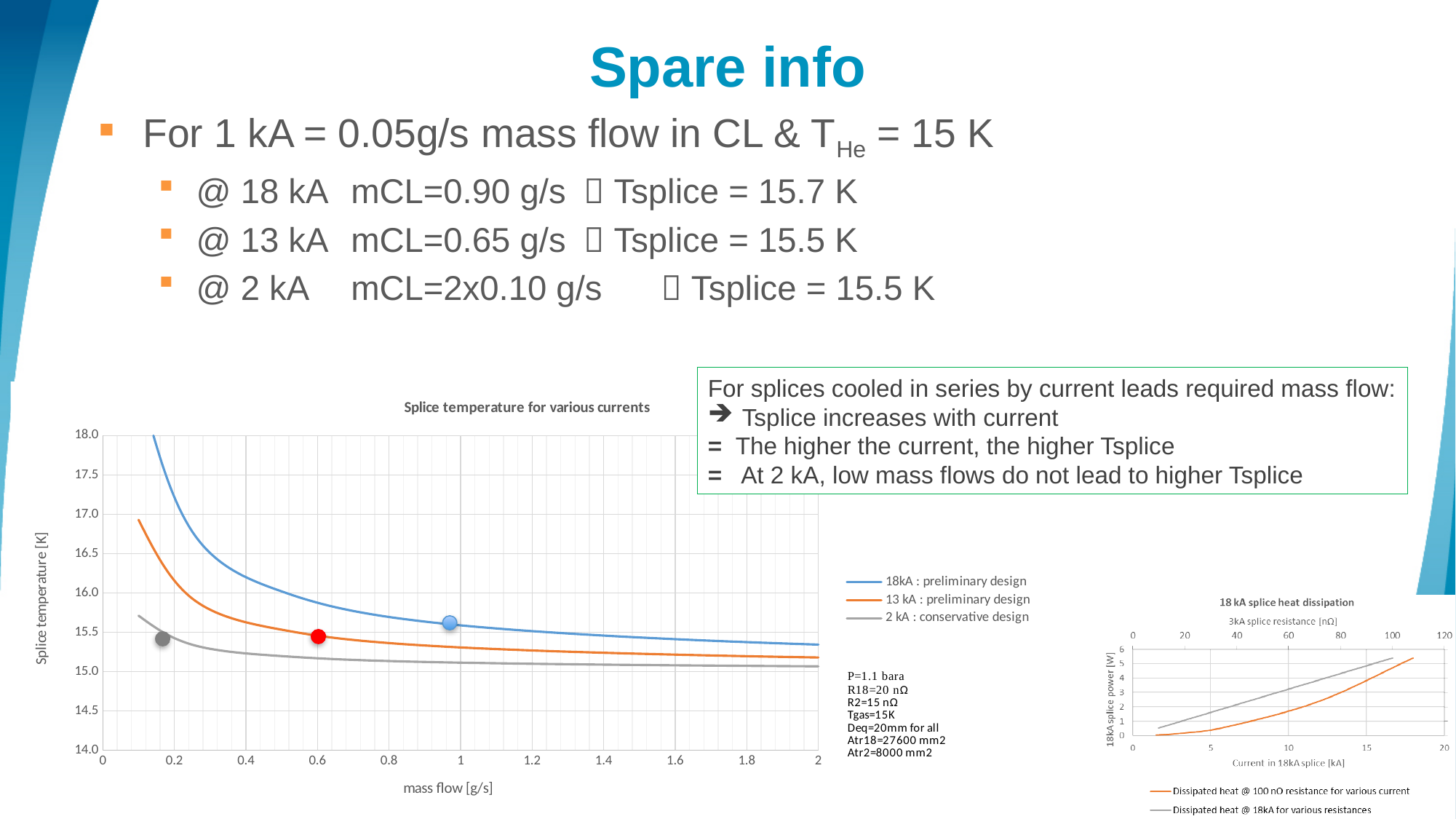
How many series does the legend of the '18 kA splice heat dissipation' chart list? 2 In the 'Splice temperature for various currents' chart, is the 18kA preliminary design value at a mass flow of 0.4 g/s greater or less than 16.0? greater In the 'Splice temperature for various currents' chart, is the 2 kA conservative design value at a mass flow of 1 g/s greater or less than 15.5? less What type of chart is 'Splice temperature for various currents'? line chart What is the x-axis label of the 'Splice temperature for various currents' chart? mass flow [g/s] In the 'Splice temperature for various currents' chart, which series has the highest splice temperature across the mass flow range? 18kA : preliminary design In the '18 kA splice heat dissipation' chart, does the dissipated heat at 100 nΩ resistance rise or fall as current increases? rise In the 'Splice temperature for various currents' chart, at a mass flow of 0.6 g/s, which is higher: the 18kA preliminary design or the 2 kA conservative design? 18kA : preliminary design In the '18 kA splice heat dissipation' chart, is the dissipated heat at 100 nΩ resistance for a current of 5 kA greater or less than 2 W? less How many series does the legend of the 'Splice temperature for various currents' chart list? 3 In the 'Splice temperature for various currents' chart, which series has the lowest splice temperature across the mass flow range? 2 kA : conservative design In the 'Splice temperature for various currents' chart, does splice temperature rise or fall as mass flow increases? fall